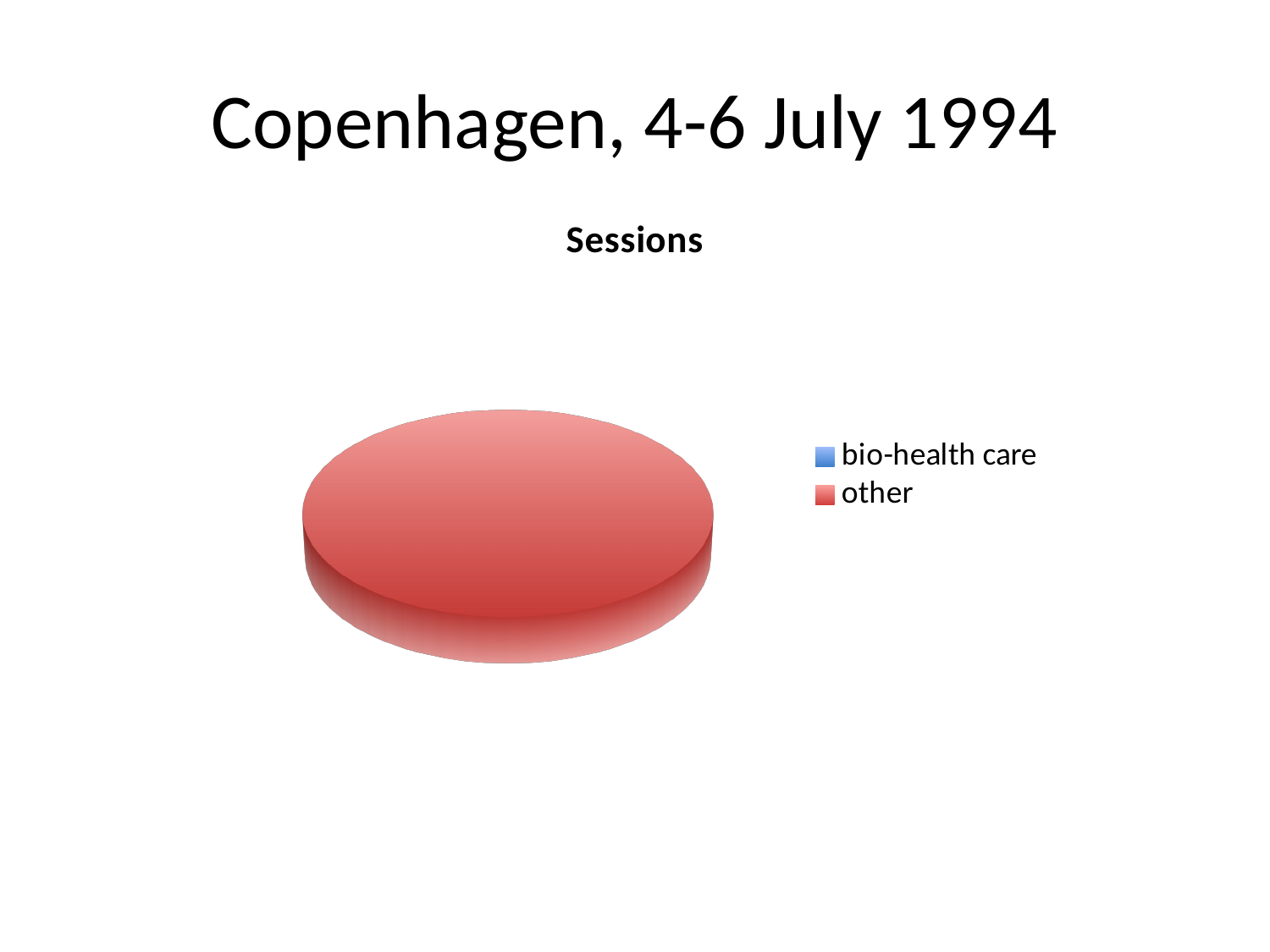
Which category has the smallest share of the pie? bio-health care What is the title of the chart? Sessions What kind of chart is shown on the slide? pie chart Which is larger in the pie chart, the share for bio-health care or the share for other? other Which category takes up the largest share of the pie? other How many entries does the chart's legend list? 2 What colour represents the 'other' category in the legend? red Is the share for 'other' greater or less than 50% of the pie? greater